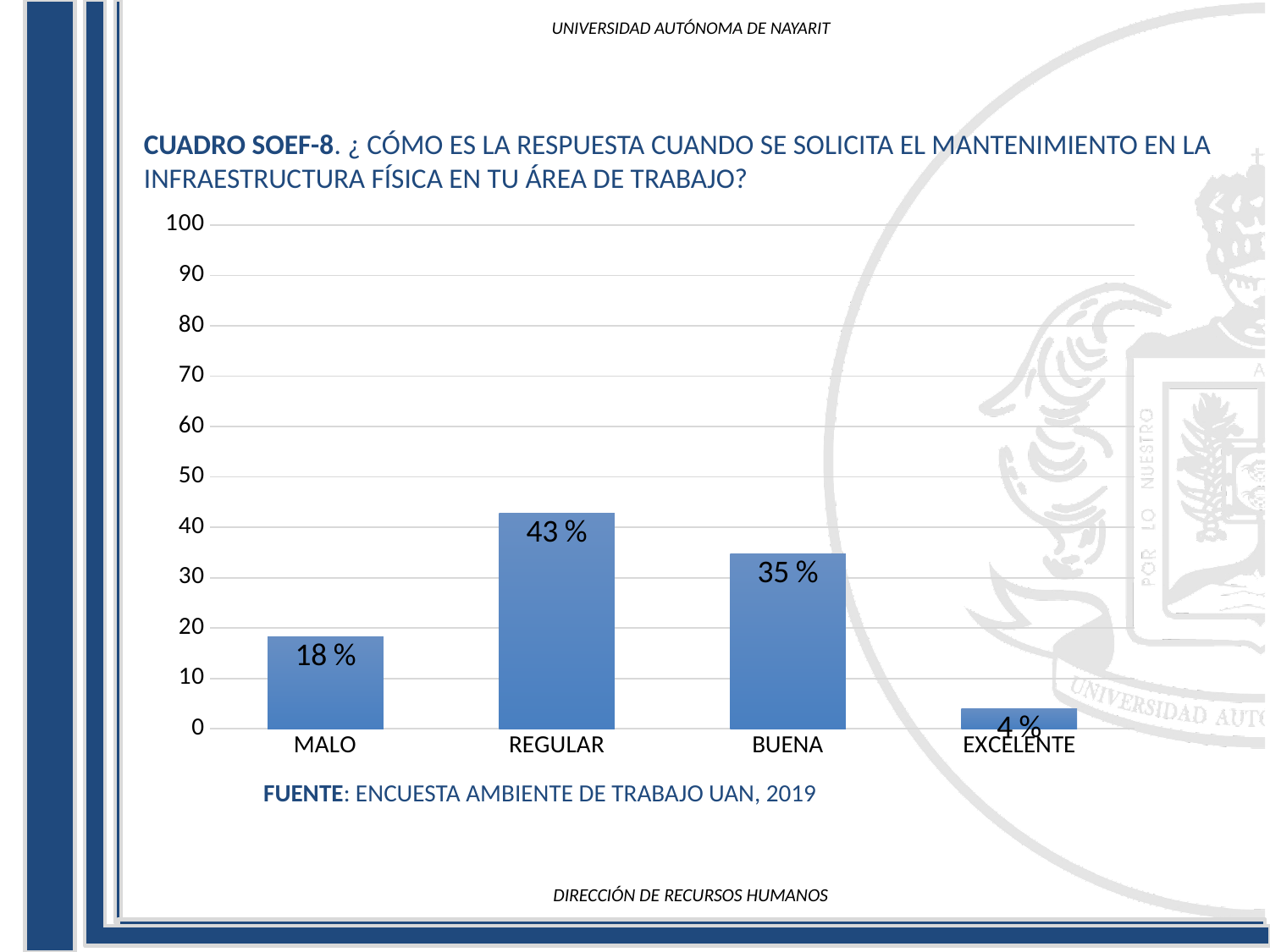
Is the value for BUENA greater or less than 30? greater How many categories are shown on the x axis? 4 Which category has the lowest value? EXCELENTE Which category has the highest value? REGULAR What is the value for EXCELENTE? 4 % What is the source cited below the chart? ENCUESTA AMBIENTE DE TRABAJO UAN, 2019 What is the value for MALO? 18 % What is the value for BUENA? 35 % What is the difference between the values for REGULAR and BUENA? 8 % What is the value for REGULAR? 43 % Which is larger, the value for MALO or the value for BUENA? BUENA What kind of chart is shown on the slide? Bar chart